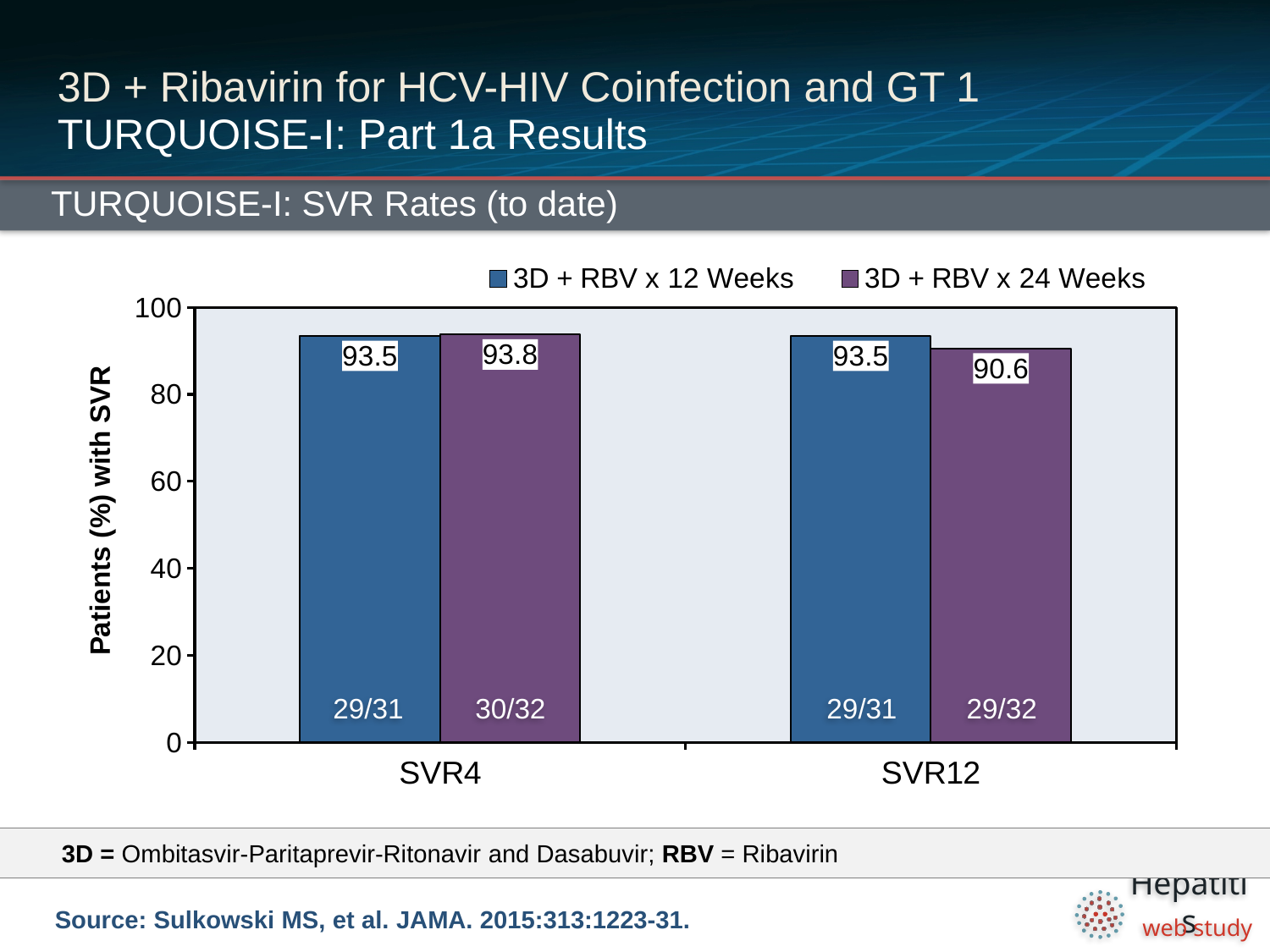
Which bar has the lowest value on the chart? 3D + RBV x 24 Weeks at SVR12 What is the value for 3D + RBV x 24 Weeks at SVR4? 93.8 How many categories are shown on the x axis? 2 Is the value for 3D + RBV x 24 Weeks at SVR12 greater or less than 80? greater At SVR12, which series has the larger value, 3D + RBV x 12 Weeks or 3D + RBV x 24 Weeks? 3D + RBV x 12 Weeks What kind of chart is shown on the slide? Bar chart What fraction of patients is shown for 3D + RBV x 12 Weeks at SVR4? 29/31 How many series does the legend list? 2 What is the value for 3D + RBV x 12 Weeks at SVR4? 93.5 What is the difference between the 3D + RBV x 12 Weeks and 3D + RBV x 24 Weeks values at SVR12? 2.9 What is the value for 3D + RBV x 24 Weeks at SVR12? 90.6 What fraction of patients is shown for 3D + RBV x 24 Weeks at SVR12? 29/32